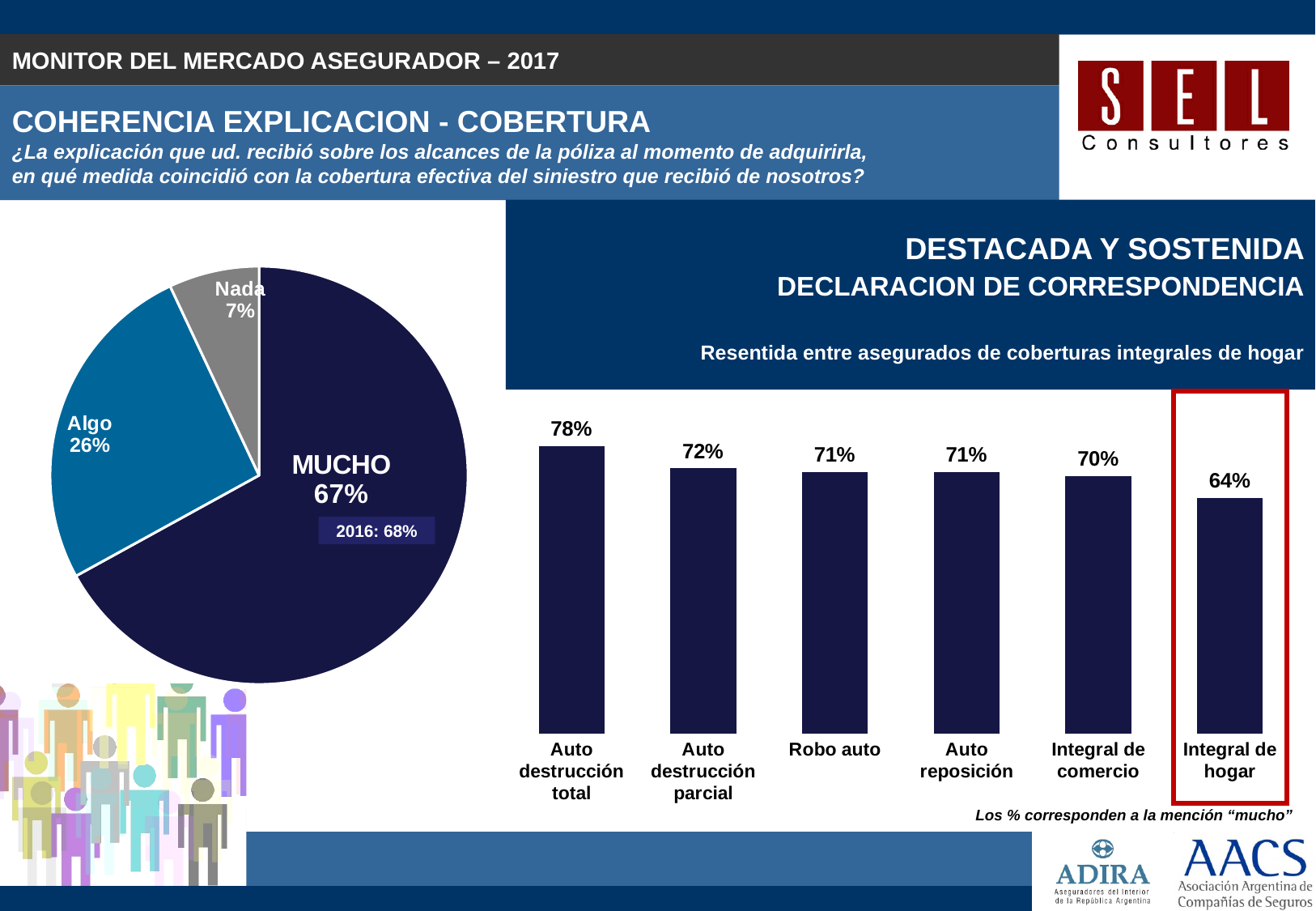
In the bar chart on the right, which category has the lowest value? Integral de hogar In the pie chart on the left, how many slices are there? 3 In the pie chart on the left, what share is labelled Algo? 26% In the pie chart on the left, which slice is the smallest? Nada In the pie chart on the left, what was the 2016 value shown for MUCHO? 68% In the bar chart on the right, which category has the highest value? Auto destrucción total In the bar chart on the right, what is the value for Auto destrucción total? 78% In the bar chart on the right, what is the difference between Auto destrucción total and Integral de hogar? 14% In the pie chart on the left, what share is labelled MUCHO? 67% In the bar chart on the right, what is the value for Integral de hogar? 64% In the bar chart on the right, how many categories are shown? 6 What kind of chart is shown on the right side of the slide? Bar chart